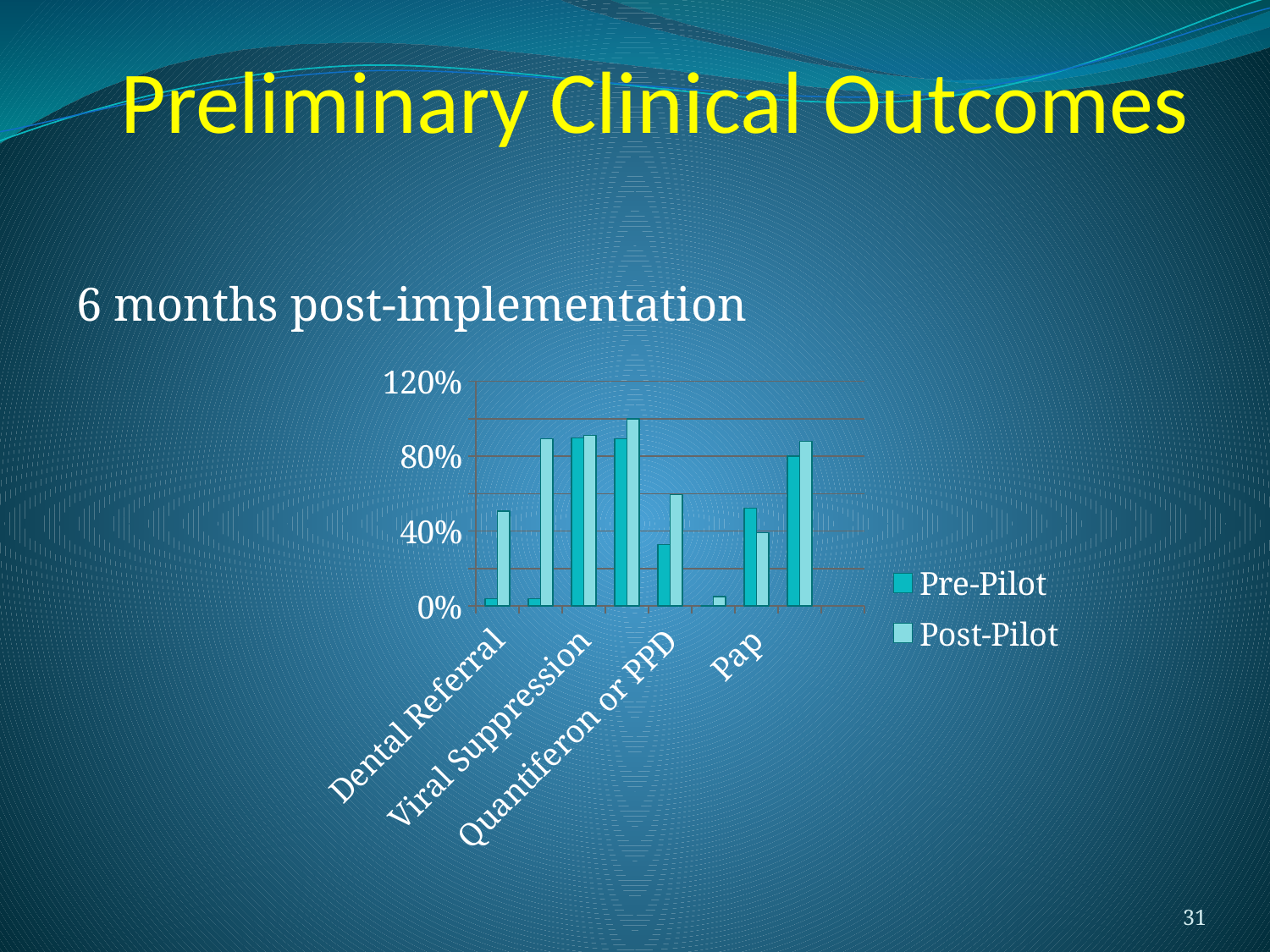
What kind of chart is shown on the slide? bar chart What are the two series named in the chart legend? Pre-Pilot and Post-Pilot Which series is shown in the lighter colour in the chart? Post-Pilot How many series does the chart legend list? 2 Is the Pre-Pilot value for Dental Referral greater or less than 40%? less Is the Post-Pilot value for Dental Referral greater or less than 40%? greater For Dental Referral, which is larger: the Pre-Pilot value or the Post-Pilot value? Post-Pilot What is the highest value shown on the chart's vertical axis? 120%